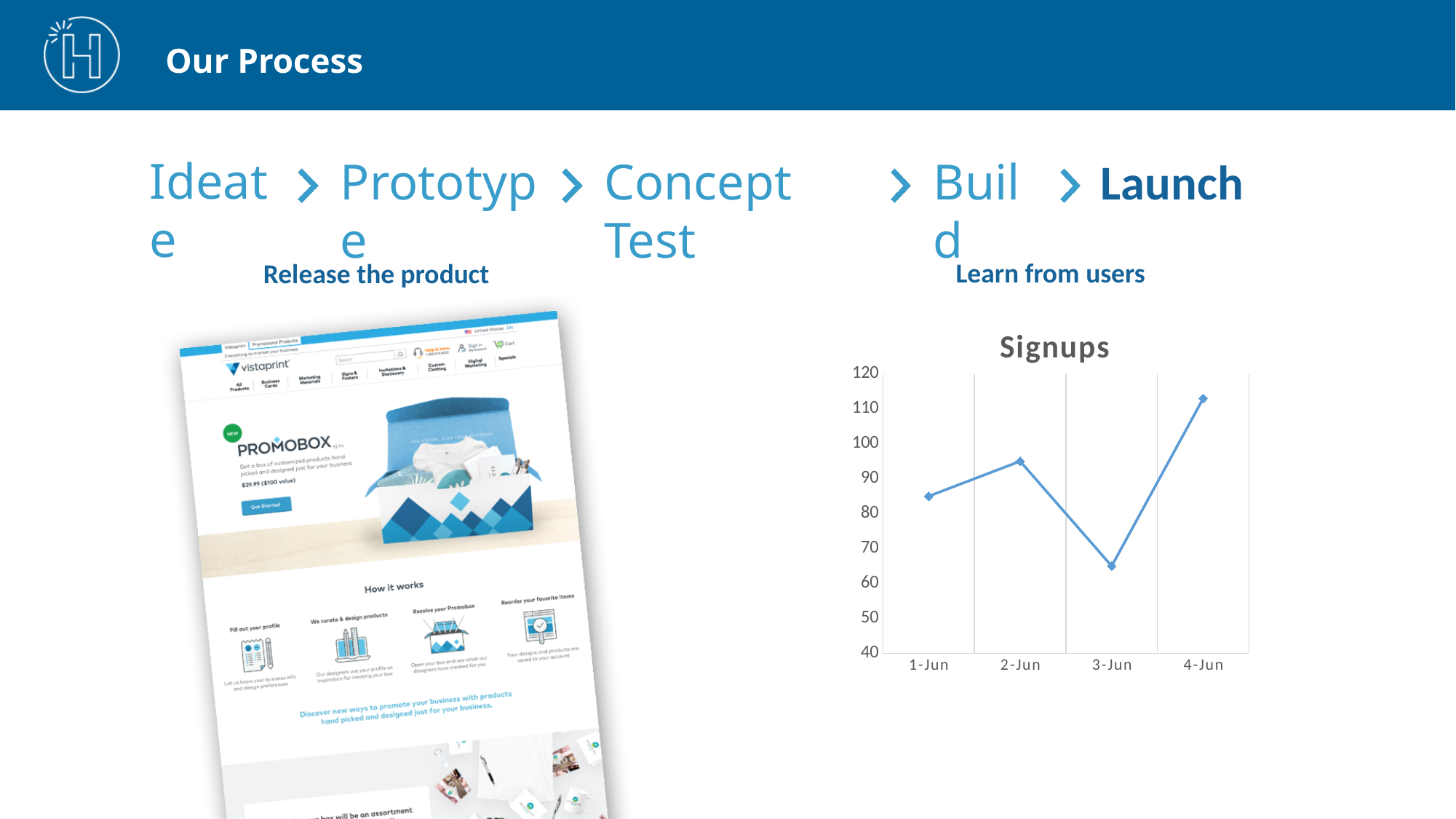
Which has more signups, 2-Jun or 3-Jun? 2-Jun Is the value for 1-Jun greater or less than 80? greater What is the title of the chart on the slide? Signups Is the value for 3-Jun greater or less than 70? less What kind of chart is the Signups chart? line chart Is the value for 4-Jun greater or less than 110? greater Do signups rise or fall from 2-Jun to 3-Jun? fall Do signups rise or fall from 3-Jun to 4-Jun? rise Which date has the lowest number of signups? 3-Jun Which date has the highest number of signups? 4-Jun How many dates are plotted on the x axis of the Signups chart? 4